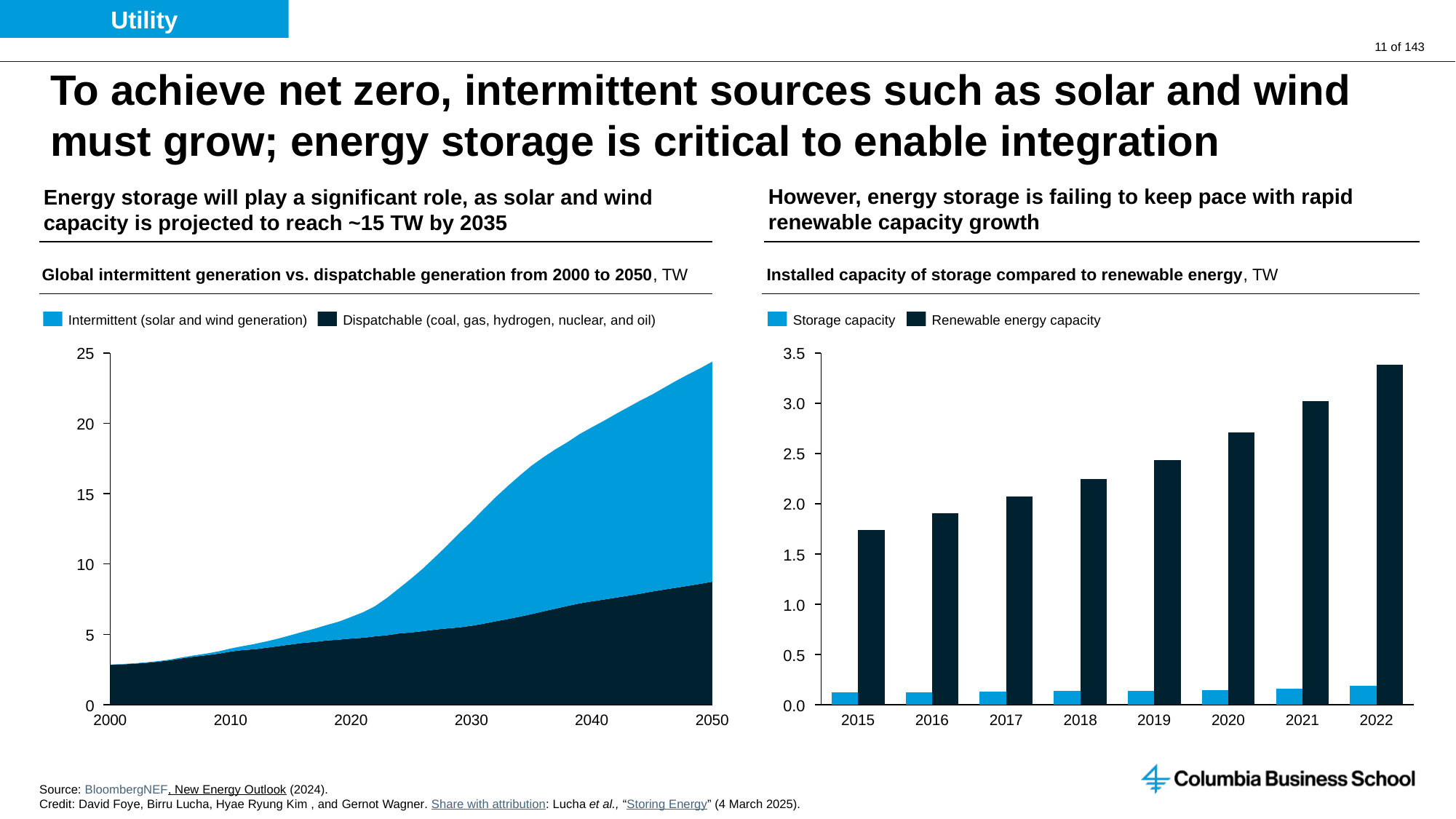
In the right-hand chart, is the storage capacity for 2022 greater or less than 0.5? less What kind of chart is the left-hand chart, 'Global intermittent generation vs. dispatchable generation from 2000 to 2050'? Stacked area chart In the right-hand chart, is the renewable energy capacity for 2022 greater or less than 3.0? greater In the right-hand chart, which is larger in 2022: storage capacity or renewable energy capacity? Renewable energy capacity In the right-hand chart, how many series does the legend list? 2 In the left-hand chart, is the total generation (intermittent plus dispatchable) in 2050 greater or less than 20? greater In the right-hand chart, does renewable energy capacity rise or fall from 2015 to 2022? Rise In the right-hand chart, how many years are shown on the x axis? 8 In the left-hand chart, what unit is given in the chart title? TW What kind of chart is the right-hand chart, 'Installed capacity of storage compared to renewable energy'? Bar chart In the right-hand chart, which year has the lowest renewable energy capacity? 2015 In the right-hand chart, which year has the highest renewable energy capacity? 2022